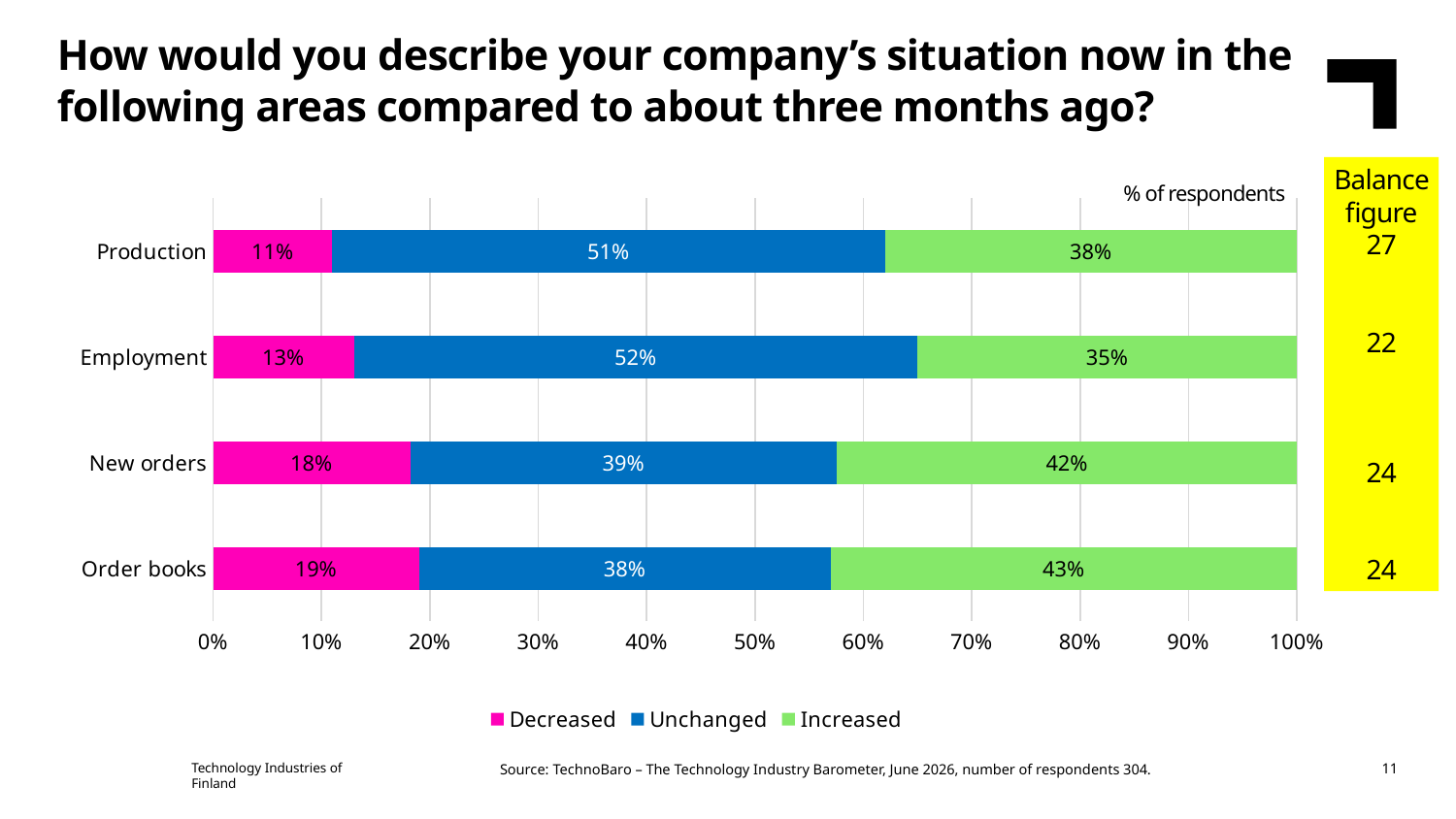
What is the balance figure shown for Production? 27 What percentage of respondents reported that Order books increased? 43% Which category has the lowest share of respondents reporting 'Increased'? Employment What percentage of respondents reported that Employment decreased? 13% What kind of chart is shown on the slide? Stacked bar chart What is the difference between the 'Increased' share for New orders and the 'Increased' share for Production? 4 percentage points What percentage of respondents reported that Production was unchanged? 51% Which is larger: the 'Unchanged' share for Employment or the 'Unchanged' share for New orders? Employment How many categories are shown on the chart? 4 Which colour represents 'Increased' in the legend? Green Which category has the highest share of respondents reporting 'Decreased'? Order books How many series does the legend list? 3